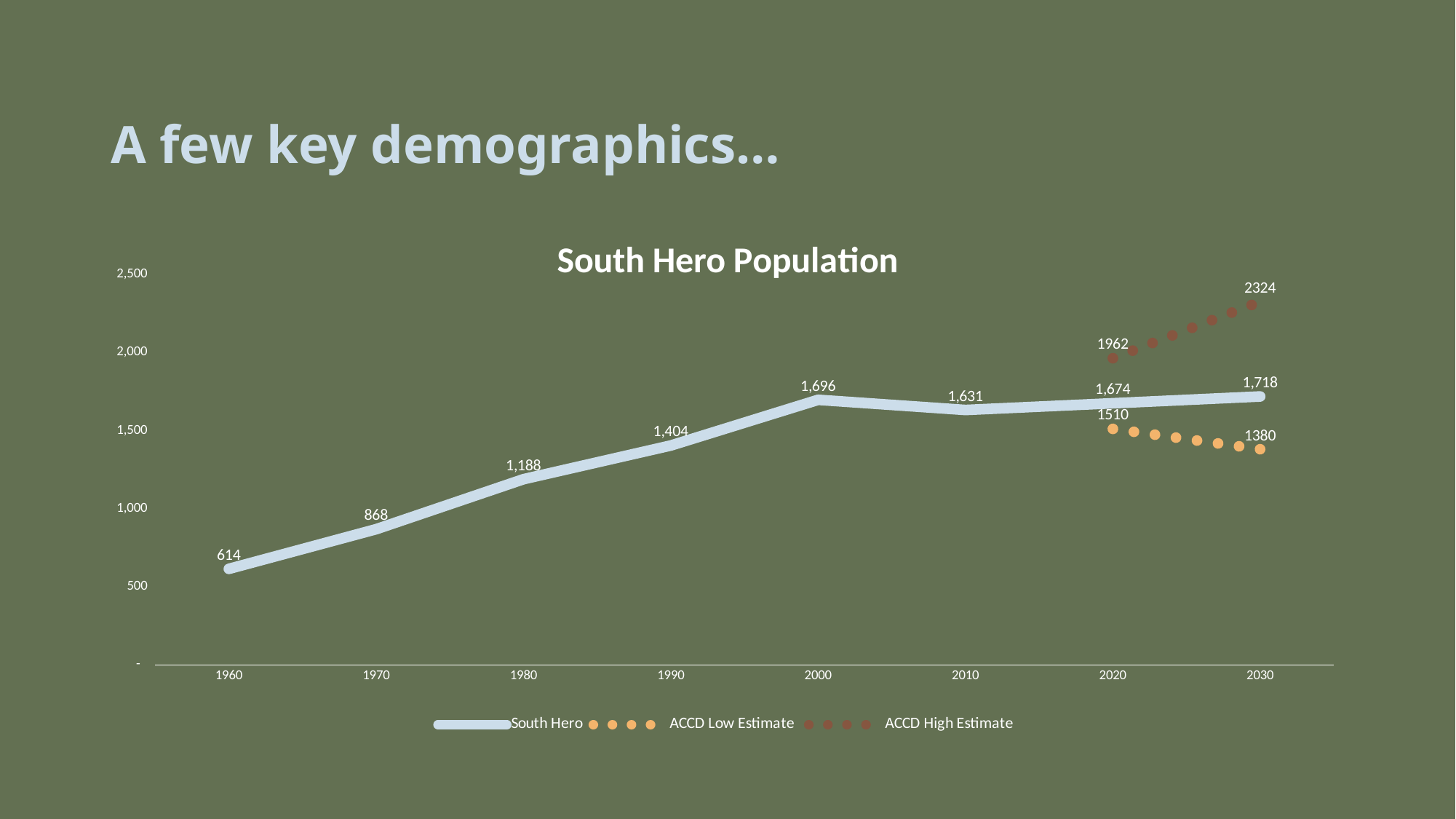
What is the South Hero population value for 1960? 614 What is the ACCD Low Estimate value for 2020? 1510 In which year does the South Hero series reach its highest value? 2030 How many series does the legend list? 3 What is the title of the chart? South Hero Population In which year is the South Hero series at its lowest value? 1960 What kind of chart is shown? Line chart What is the ACCD High Estimate value for 2030? 2324 What is the difference between the South Hero values for 2000 and 2010? 65 Does the ACCD Low Estimate series rise or fall from 2020 to 2030? Fall What is the South Hero population value for 2000? 1,696 Which is larger in 2030: the ACCD High Estimate or the South Hero value? ACCD High Estimate